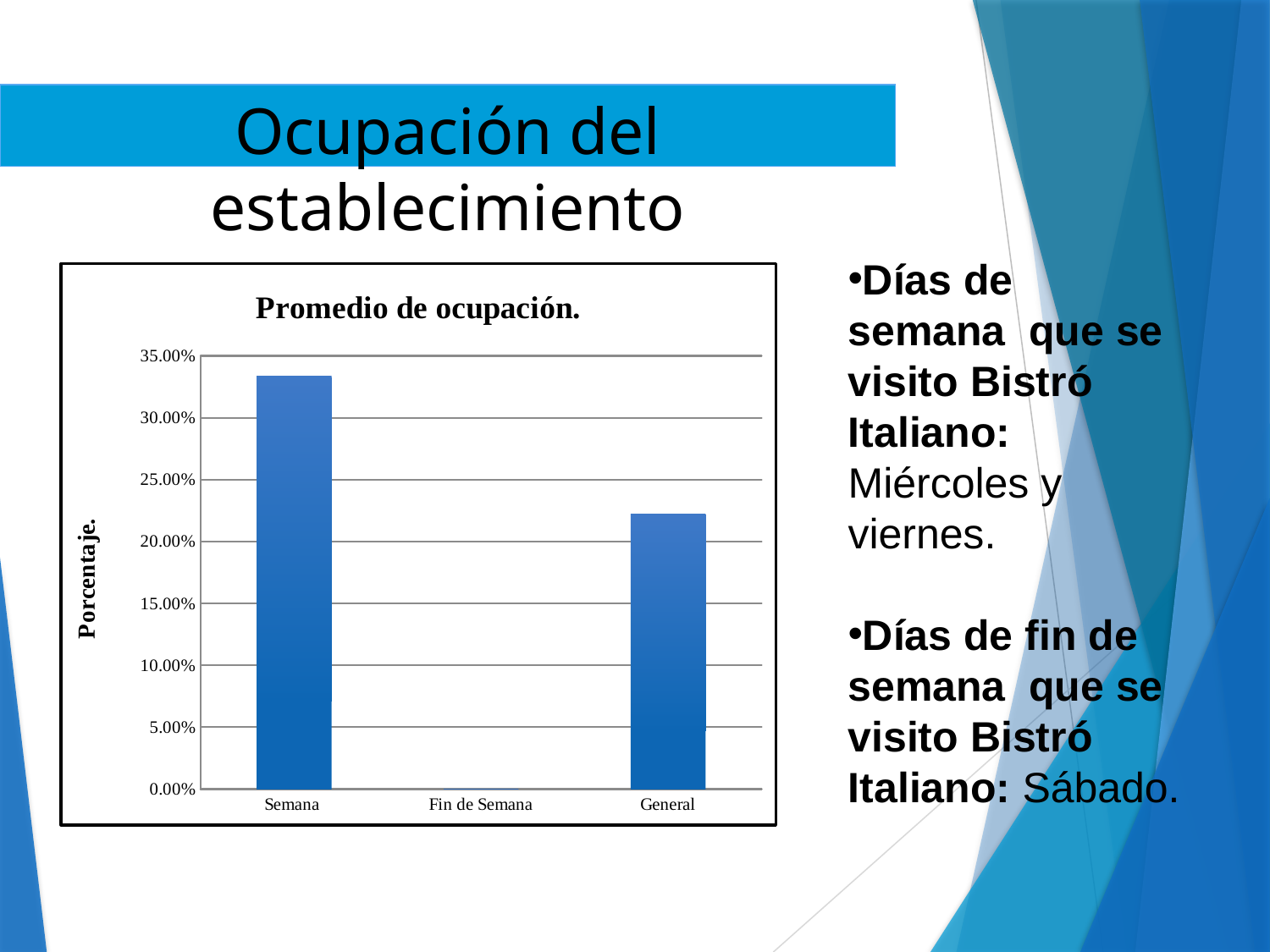
What is the title of the chart? Promedio de ocupación. Which is larger, the value for Semana or the value for General? Semana What is the highest value shown on the vertical axis of the chart? 35.00% Is the value for Semana greater or less than 30.00%? greater Is the value for General greater or less than 25.00%? less Is the value for General greater or less than 20.00%? greater What is the label of the vertical axis of the chart? Porcentaje. What kind of chart is shown on the slide? bar chart Which category has the lowest value in the chart? Fin de Semana Which category has the highest value in the chart? Semana How many categories are shown on the x axis of the chart? 3